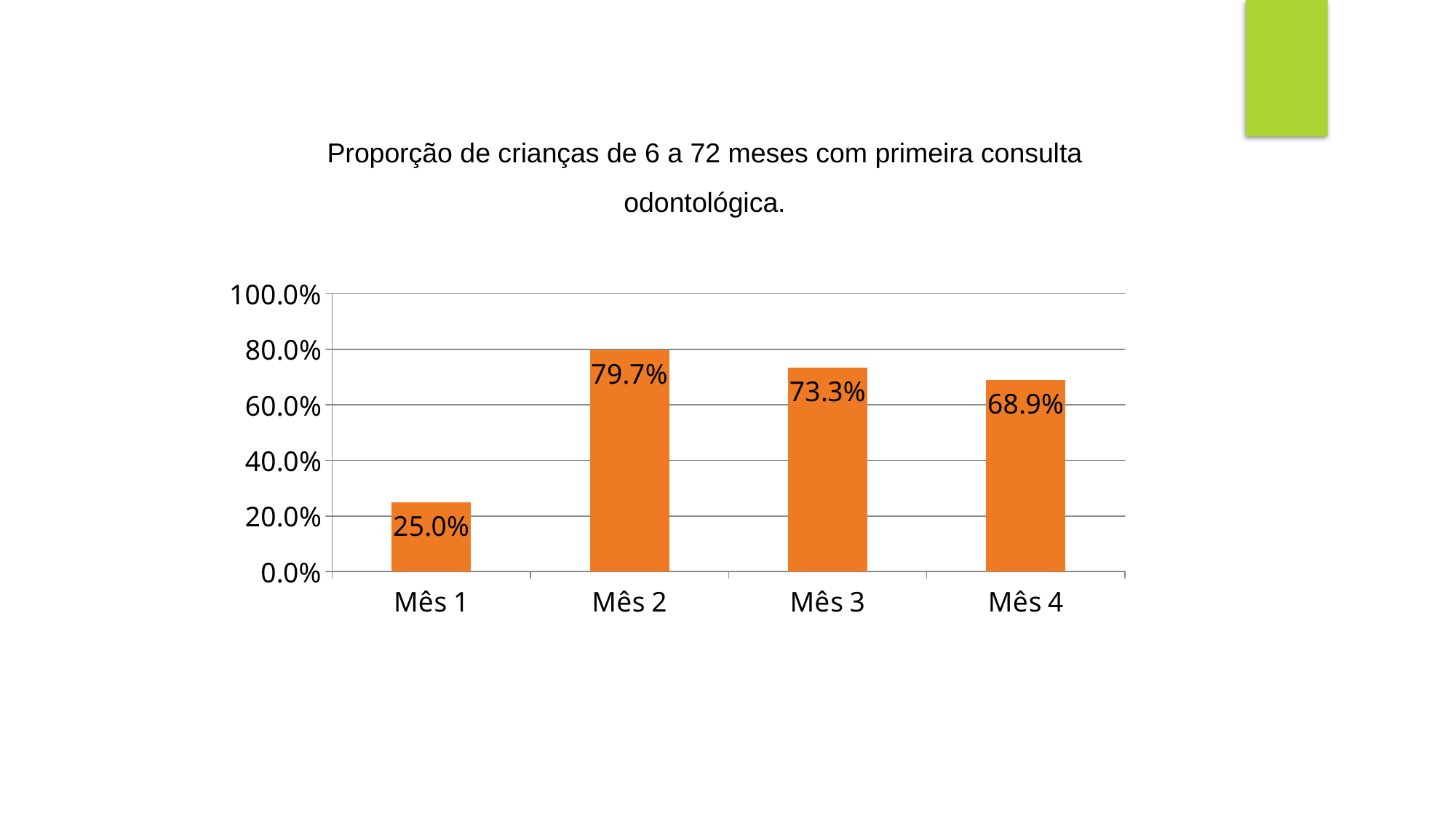
What is the value for Mês 2? 79.7% What kind of chart is shown on the slide? Bar chart What is the difference between the values for Mês 2 and Mês 1? 54.7% What is the difference between the values for Mês 3 and Mês 4? 4.4% What is the value for Mês 3? 73.3% What is the value for Mês 4? 68.9% How many months are shown on the x axis? 4 What is the value for Mês 1? 25.0% Which is larger, the value for Mês 3 or the value for Mês 4? Mês 3 Which month has the lowest value? Mês 1 Which month has the highest value? Mês 2 What is the title of the chart? Proporção de crianças de 6 a 72 meses com primeira consulta odontológica.